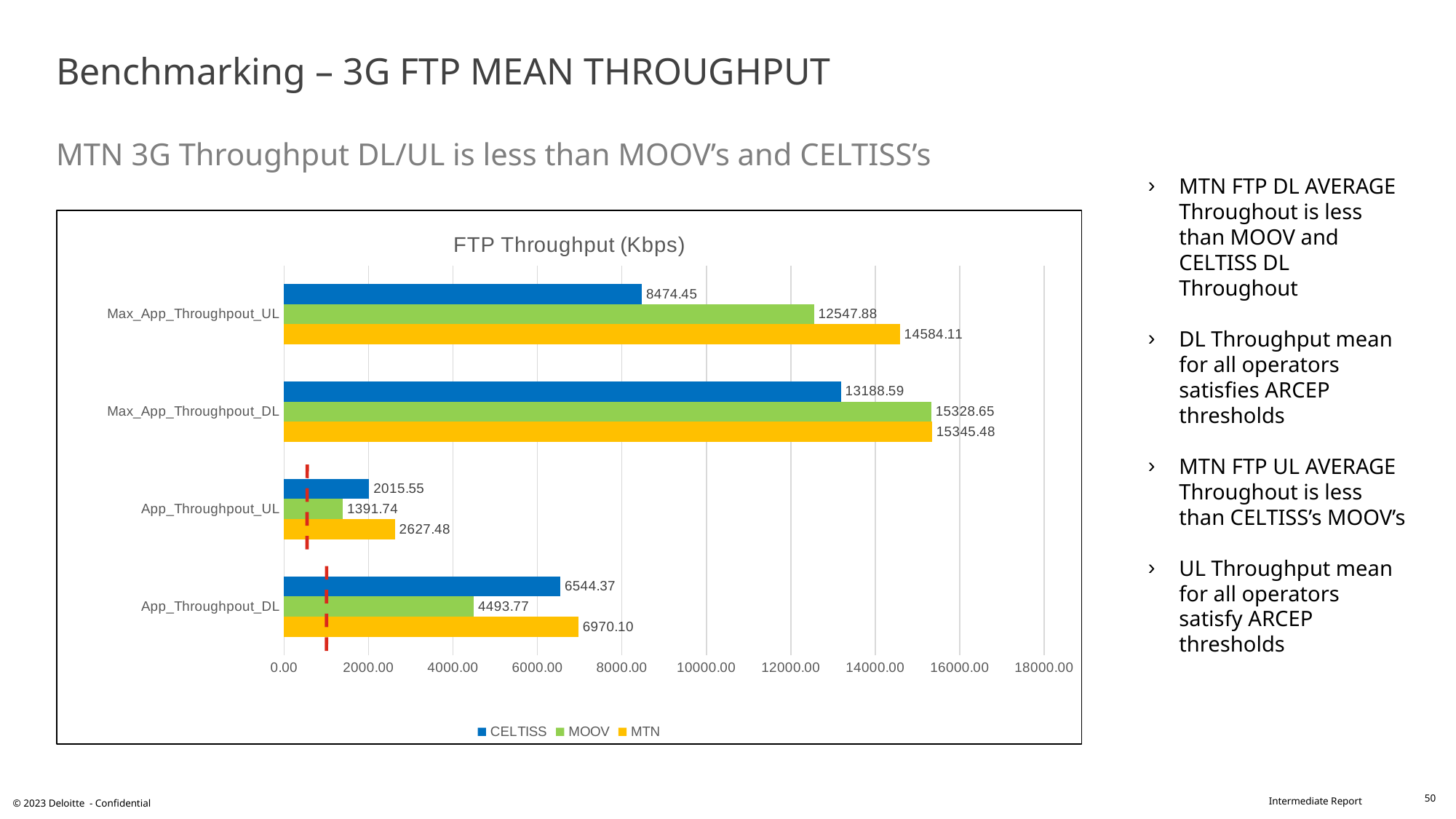
Which operator has the highest value for Max_App_Throughpout_UL? MTN Is the CELTISS value for Max_App_Throughpout_DL greater or less than 12000.00? greater What is the difference between the MTN and CELTISS values for App_Throughpout_DL? 425.73 How many categories are shown on the chart? 4 What is the difference between the MTN and MOOV values for Max_App_Throughpout_UL? 2036.23 What is the MOOV value for App_Throughpout_UL? 1391.74 What is the CELTISS value for Max_App_Throughpout_UL? 8474.45 What is the MTN value for App_Throughpout_DL? 6970.10 Which operator has the lowest value for App_Throughpout_DL? MOOV For App_Throughpout_UL, which is larger: the CELTISS value or the MOOV value? CELTISS How many series does the legend list? 3 What type of chart is shown on the slide? Bar chart